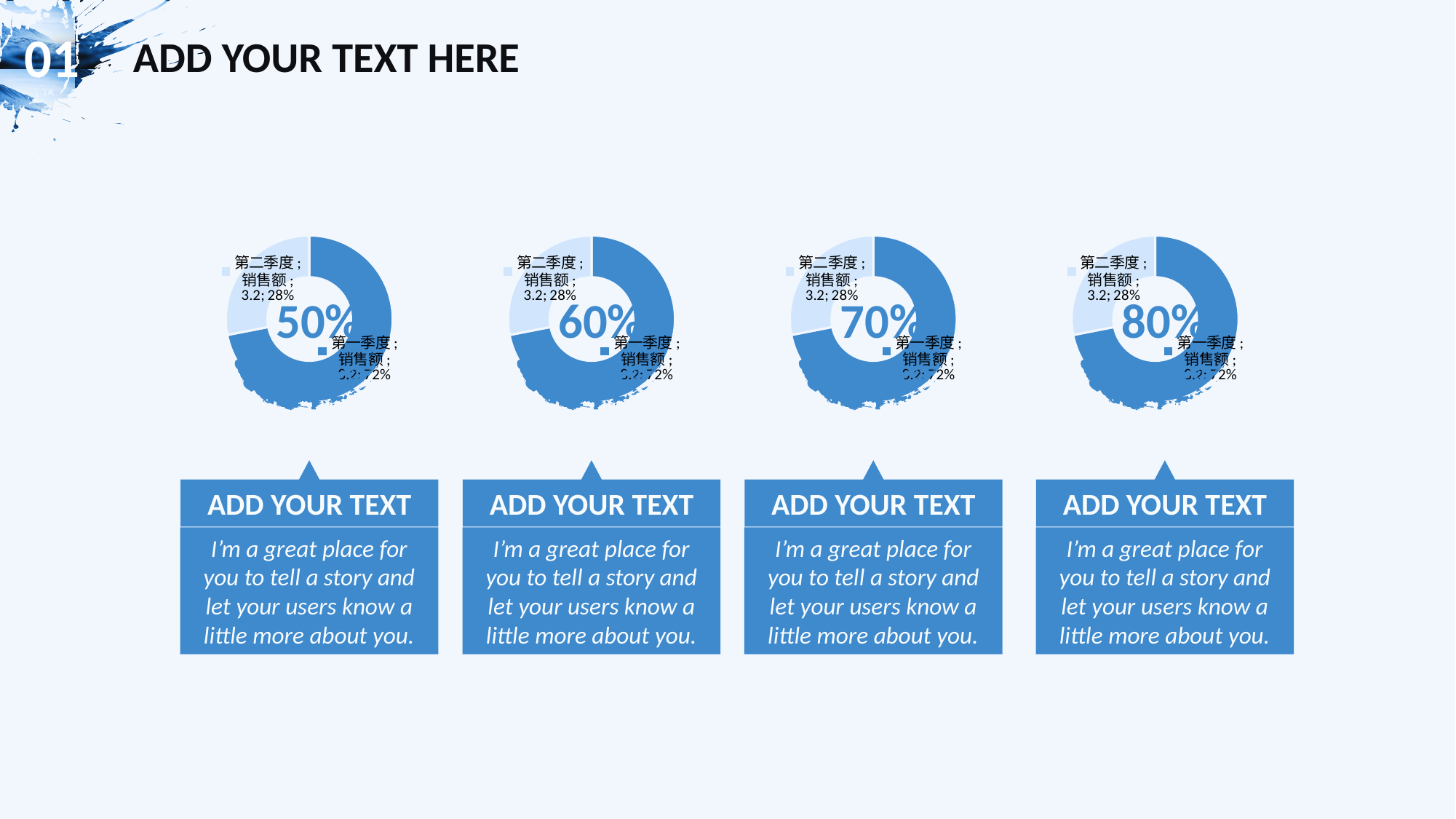
In the rightmost chart, which slice is the smallest? 第二季度 销售额 What kind of chart is the leftmost chart on the slide? doughnut chart How many doughnut charts are shown on the slide? 4 In the leftmost chart, what share of the doughnut does 第二季度 销售额 take? 28% In the leftmost chart, is the 第二季度 销售额 slice shown in a lighter or darker blue than the 第一季度 销售额 slice? lighter In the rightmost chart, which slice is larger, 第一季度 销售额 or 第二季度 销售额? 第一季度 销售额 In the leftmost chart, which slice is the largest? 第一季度 销售额 In the third chart from the left, what is the difference in percentage share between 第一季度 销售额 and 第二季度 销售额? 44% In the third chart from the left, what is the value labelled for 第二季度 销售额? 3.2 In the second chart from the left, what share of the doughnut does 第一季度 销售额 take? 72% How many slices does the second chart from the left have? 2